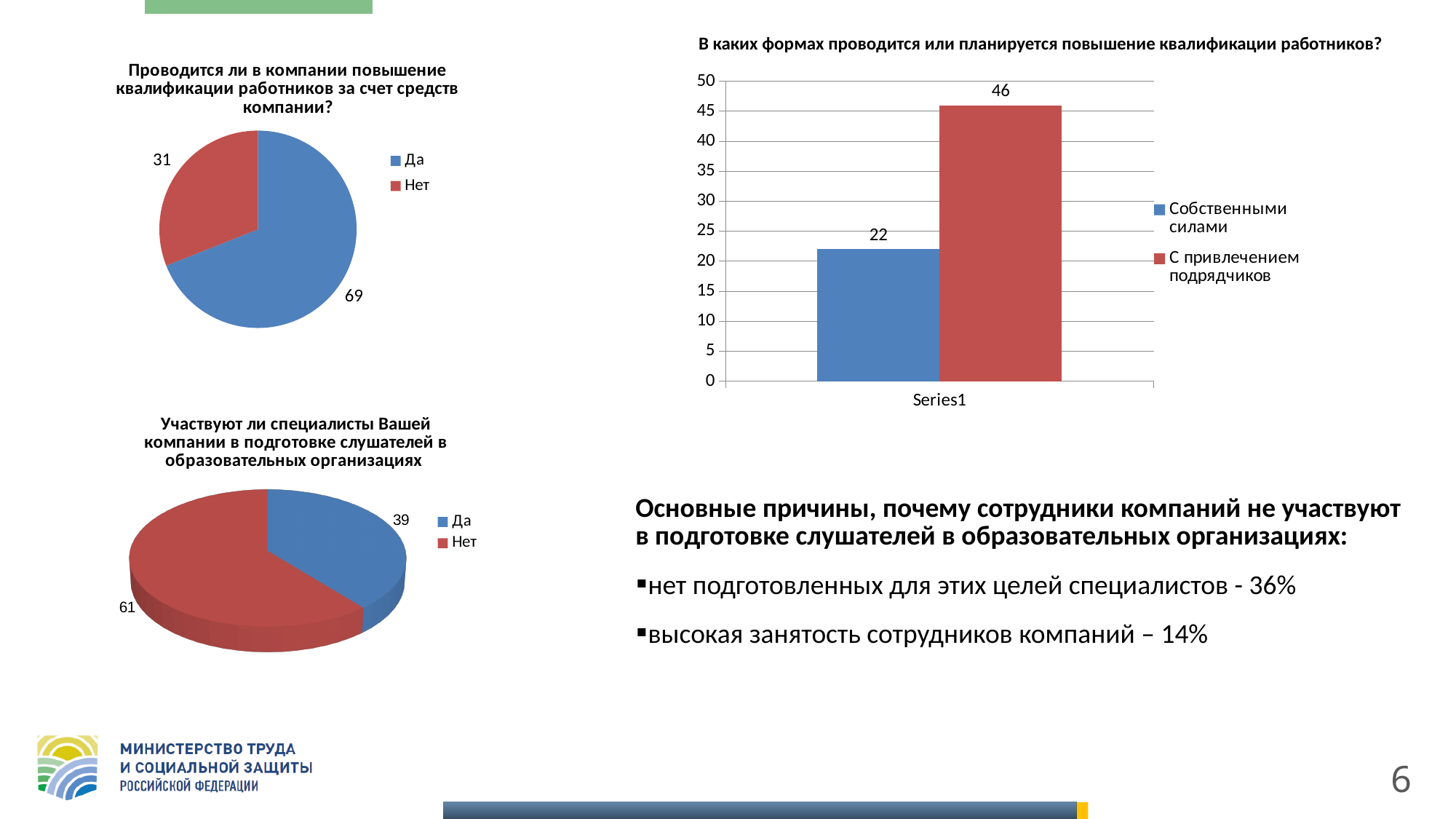
In the bottom-left pie chart 'Участвуют ли специалисты Вашей компании в подготовке слушателей в образовательных организациях', what is the value for 'Да'? 39 In the bar chart 'В каких формах проводится или планируется повышение квалификации работников?', what is the value for 'Собственными силами'? 22 In the top-left pie chart 'Проводится ли в компании повышение квалификации работников за счет средств компании?', what is the difference between the 'Да' and 'Нет' values? 38 In the bottom-left pie chart 'Участвуют ли специалисты Вашей компании в подготовке слушателей в образовательных организациях', what is the value for 'Нет'? 61 In the top-left pie chart 'Проводится ли в компании повышение квалификации работников за счет средств компании?', what is the value for 'Да'? 69 In the bar chart 'В каких формах проводится или планируется повышение квалификации работников?', what is the value for 'С привлечением подрядчиков'? 46 In the bar chart 'В каких формах проводится или планируется повышение квалификации работников?', what is the difference between 'С привлечением подрядчиков' and 'Собственными силами'? 24 In the bottom-left pie chart 'Участвуют ли специалисты Вашей компании в подготовке слушателей в образовательных организациях', which slice is the largest? Нет In the bar chart 'В каких формах проводится или планируется повышение квалификации работников?', how many series does the legend list? 2 What kind of chart is the chart titled 'В каких формах проводится или планируется повышение квалификации работников?'? Bar chart In the top-left pie chart 'Проводится ли в компании повышение квалификации работников за счет средств компании?', which slice is larger, 'Да' or 'Нет'? Да In the top-left pie chart 'Проводится ли в компании повышение квалификации работников за счет средств компании?', what is the value for 'Нет'? 31